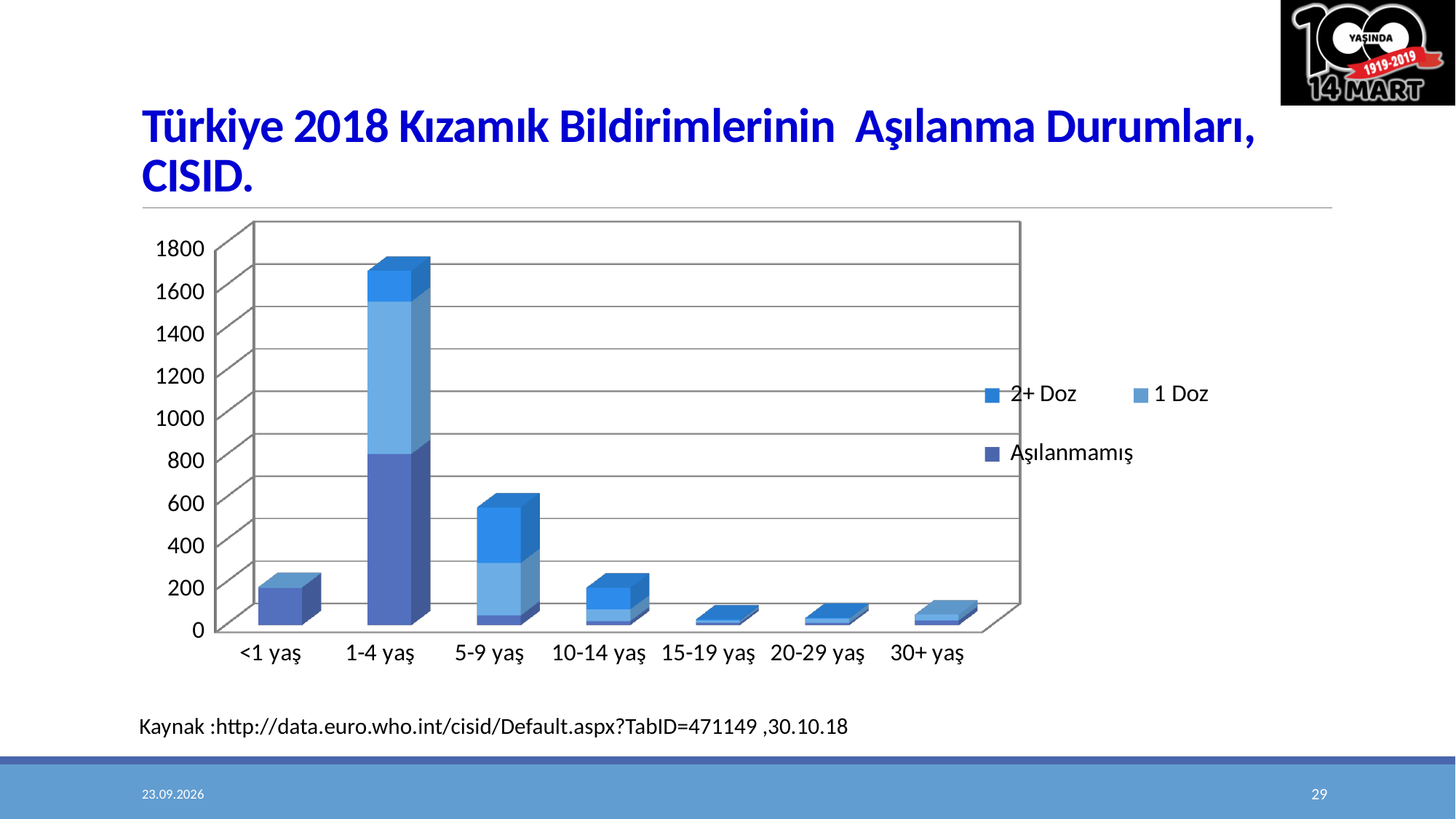
What kind of chart is shown on the slide? Stacked bar chart Is the total value for 1-4 yaş greater or less than 1400? greater Which has a larger total bar, 1-4 yaş or 5-9 yaş? 1-4 yaş Which age category has the highest total bar? 1-4 yaş What are the three series named in the legend? 2+ Doz, 1 Doz, Aşılanmamış Which series makes up the entire bar for <1 yaş? Aşılanmamış From 1-4 yaş to 15-19 yaş, do the total bar values rise or fall? fall Is the total value for <1 yaş greater or less than 400? less Is the total value for 5-9 yaş greater or less than 800? less How many series does the legend list? 3 How many age categories are shown on the x axis? 7 Which has a larger total bar, 5-9 yaş or 10-14 yaş? 5-9 yaş